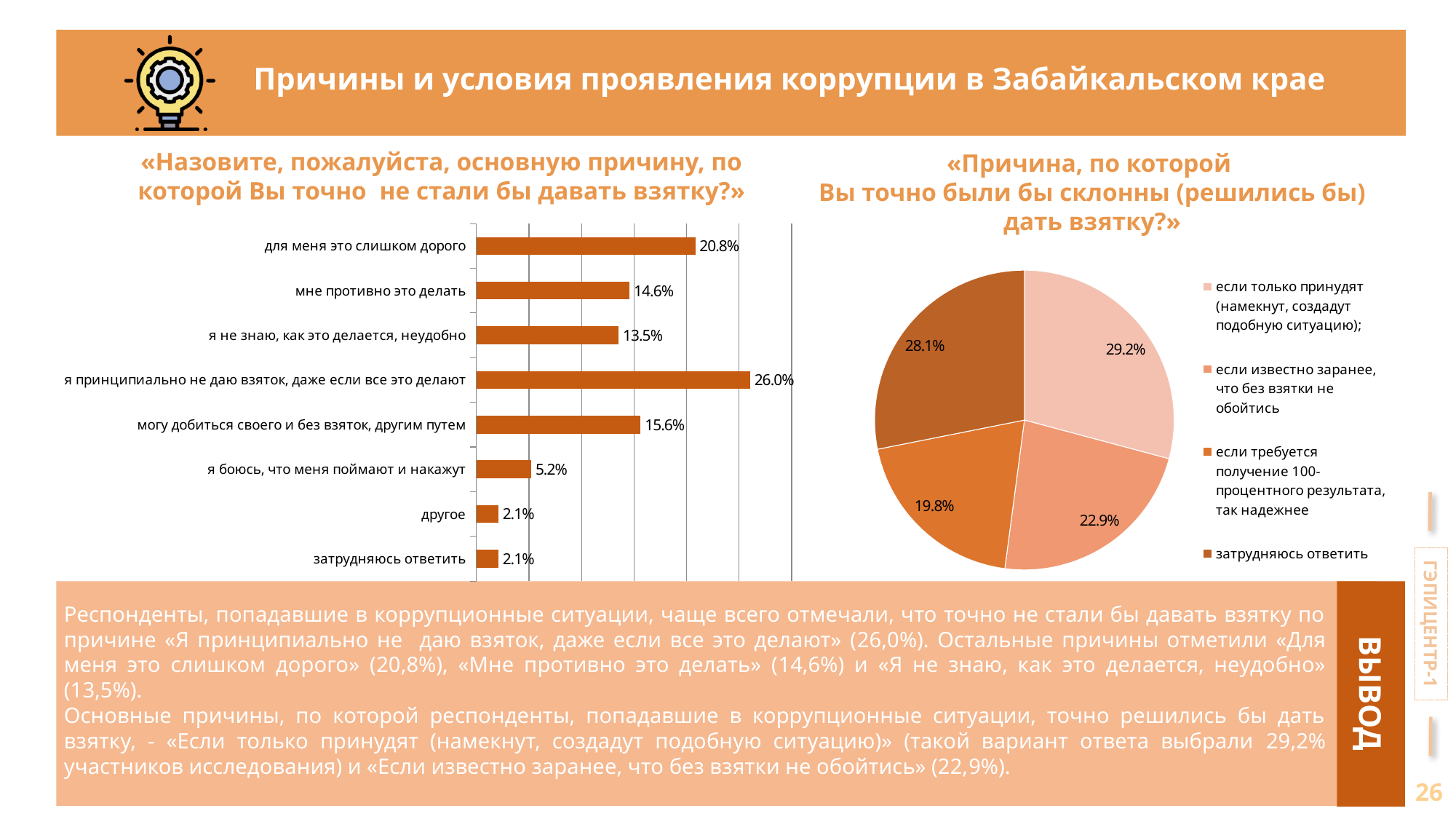
How many entries does the legend of the right pie chart list? 4 What type of chart is the left chart on the slide? bar chart What type of chart is the right chart on the slide? pie chart On the right pie chart, which slice is the smallest? если требуется получение 100-процентного результата, так надежнее On the left bar chart, what is the difference between «я принципиально не даю взяток, даже если все это делают» and «мне противно это делать»? 11.4% How many categories are shown on the left bar chart? 8 On the right pie chart, what is the value for «затрудняюсь ответить»? 28.1% On the right pie chart «Причина, по которой Вы точно были бы склонны (решились бы) дать взятку?», what share is «если только принудят (намекнут, создадут подобную ситуацию)»? 29.2% On the left chart «Назовите, пожалуйста, основную причину, по которой Вы точно не стали бы давать взятку?», what is the value for «для меня это слишком дорого»? 20.8% On the left bar chart, what is the value for «я боюсь, что меня поймают и накажут»? 5.2% On the left bar chart, which is larger: «могу добиться своего и без взяток, другим путем» or «я не знаю, как это делается, неудобно»? могу добиться своего и без взяток, другим путем On the left bar chart, which category has the highest value? я принципиально не даю взяток, даже если все это делают